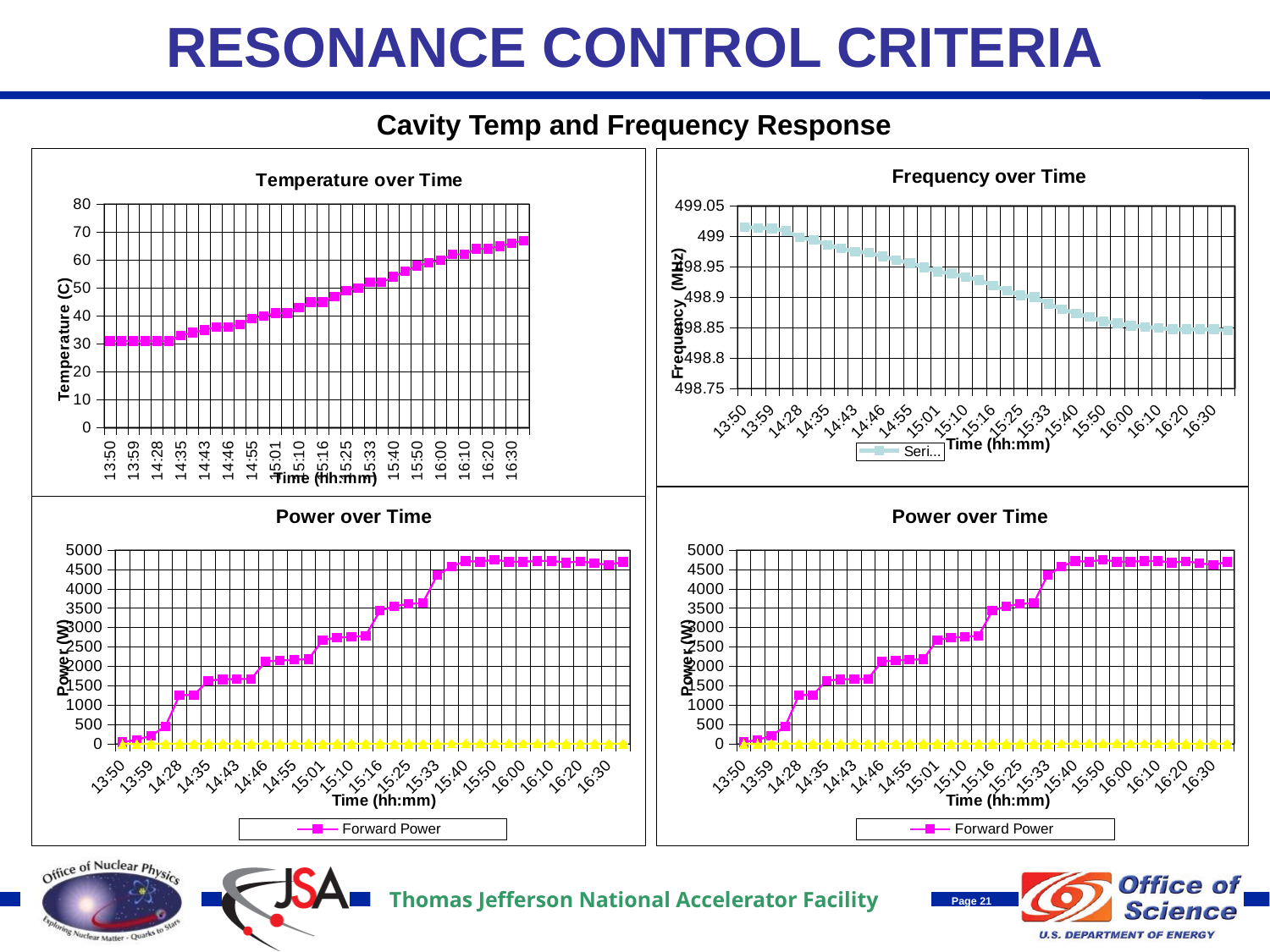
In the "Frequency over Time" chart, is the value at 16:30 greater or less than 498.9? less In the bottom-left "Power over Time" chart, is the Forward Power value at 16:30 greater or less than 4500? greater How many series does the legend of the bottom-left "Power over Time" chart list? 1 In the "Temperature over Time" chart, is the value at 16:30 greater or less than 60? greater What kind of chart is the "Temperature over Time" chart? line chart In the "Temperature over Time" chart, do the values rise or fall along the x axis? rise What is the y-axis label of the "Frequency over Time" chart? Frequency (MHz) In the "Frequency over Time" chart, do the values rise or fall along the x axis? fall In the bottom-right "Power over Time" chart, do the Forward Power values rise or fall along the x axis? rise